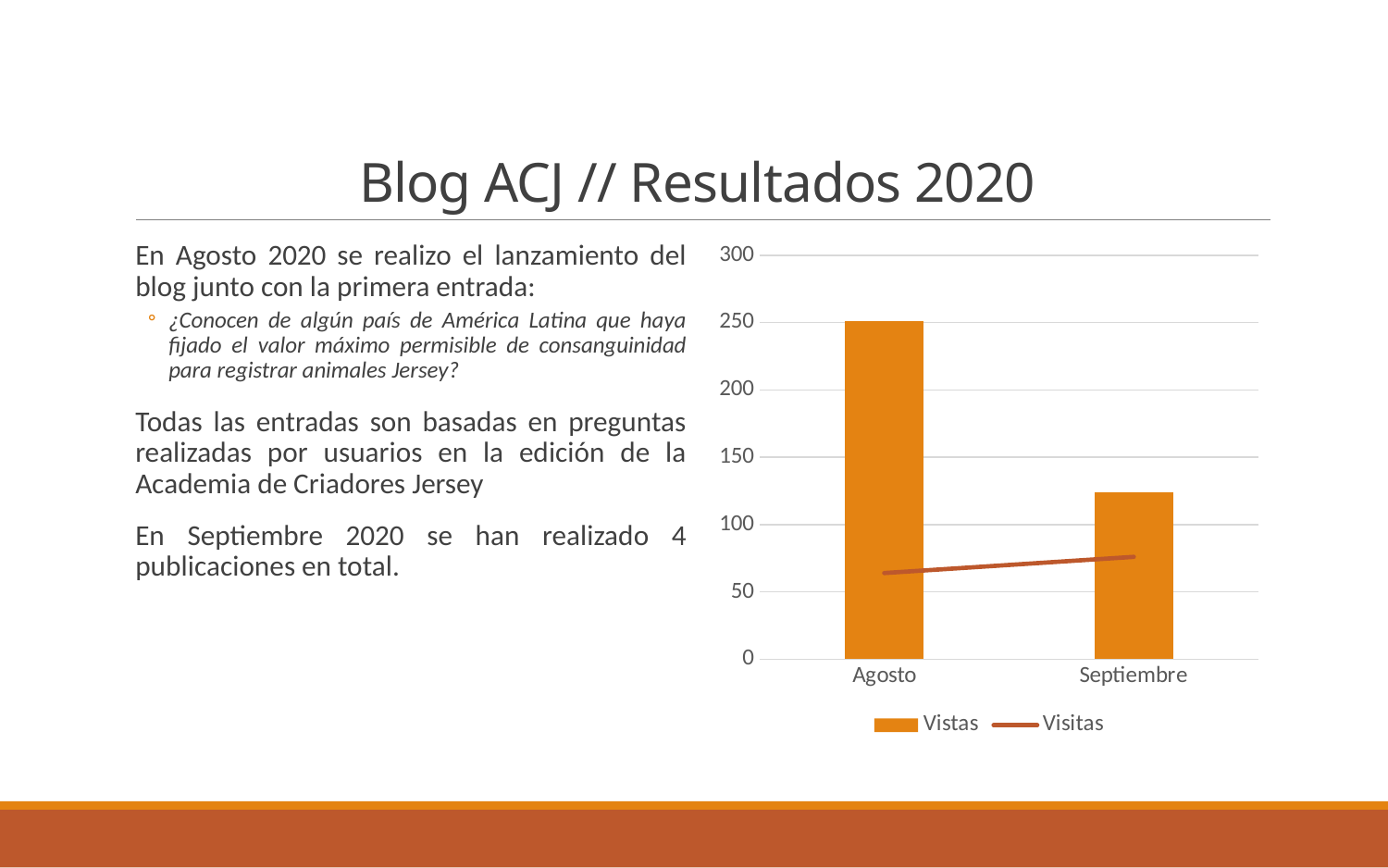
Which is larger, the Vistas value for Agosto or for Septiembre? Agosto Does the Visitas line rise or fall from Agosto to Septiembre? rise Which category has the highest Vistas value? Agosto How many categories are shown on the x axis of the chart? 2 Is the Vistas value for Septiembre greater or less than 100? greater What are the two series named in the chart legend? Vistas and Visitas How many series does the chart legend list? 2 What kind of chart is used to show the Vistas series? bar chart Which category has the lowest Vistas value? Septiembre Is the Visitas value for Agosto greater or less than 100? less Is the Vistas value for Septiembre greater or less than 150? less